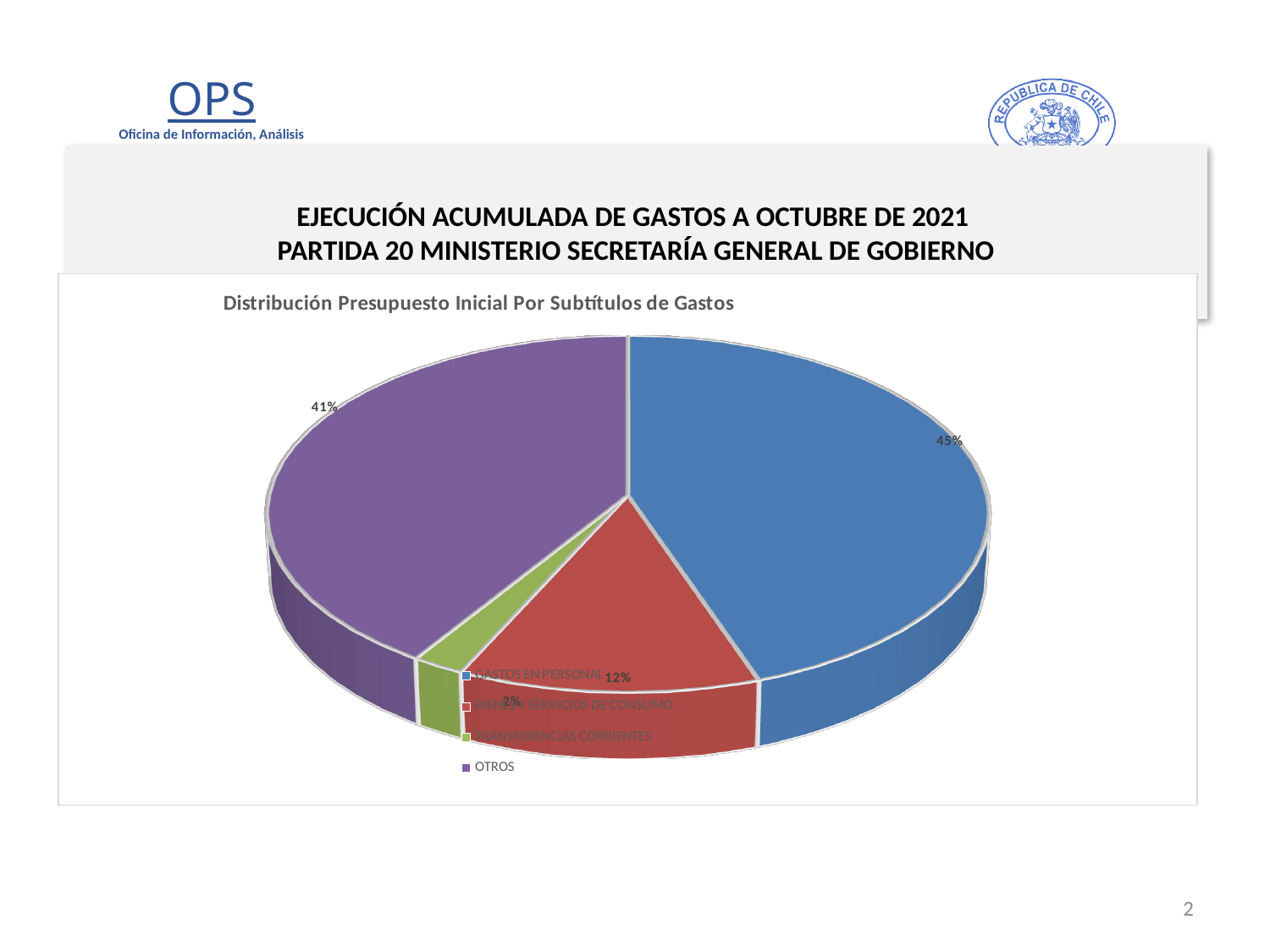
How many entries does the legend list? 4 What share of the pie is TRANSFERENCIAS CORRIENTES? 2% Which is larger, the share for BIENES Y SERVICIOS DE CONSUMO or the share for TRANSFERENCIAS CORRIENTES? BIENES Y SERVICIOS DE CONSUMO What share of the pie is GASTOS EN PERSONAL? 45% How many slices does the pie chart have? 4 Which category has the largest share of the pie? GASTOS EN PERSONAL What kind of chart is shown on the slide? pie chart Which category has the smallest share of the pie? TRANSFERENCIAS CORRIENTES What is the difference in percentage points between GASTOS EN PERSONAL and OTROS? 4 What share of the pie is OTROS? 41% What is the chart's title? Distribución Presupuesto Inicial Por Subtítulos de Gastos